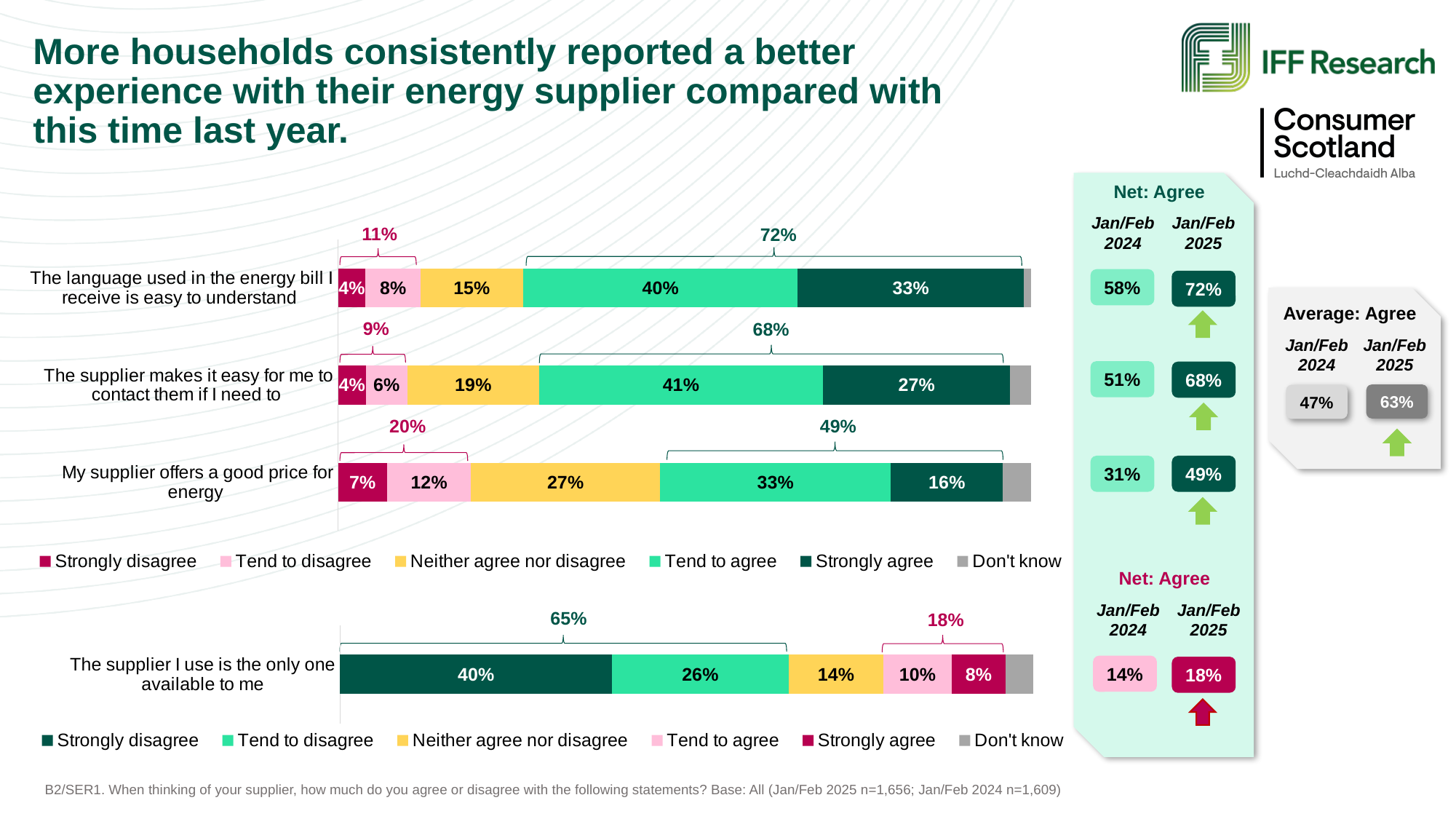
In the upper chart, what percentage tend to agree that the supplier makes it easy for them to contact them if they need to? 41% In the Net: Agree panel, what was the net agree percentage in Jan/Feb 2024 for 'My supplier offers a good price for energy'? 31% What kind of chart is used to show the responses on this slide? Stacked bar chart How many statements are plotted in the upper chart? 3 In the upper chart, what is the difference between the 'Tend to agree' percentages for 'The supplier makes it easy for me to contact them if I need to' and 'My supplier offers a good price for energy'? 8% In the upper chart, is the 'Tend to disagree' percentage larger for 'The language used in the energy bill I receive is easy to understand' or for 'My supplier offers a good price for energy'? My supplier offers a good price for energy In the upper chart, which statement has the lowest 'Strongly agree' percentage? My supplier offers a good price for energy In the lower chart, what percentage strongly disagree that the supplier they use is the only one available to them? 40% In the upper chart, what percentage neither agree nor disagree that their supplier offers a good price for energy? 27% In the upper chart, which statement has the highest 'Strongly disagree' percentage? My supplier offers a good price for energy In the upper chart, what percentage strongly agree that the language used in the energy bill they receive is easy to understand? 33% How many series does the legend of the upper chart list? 6